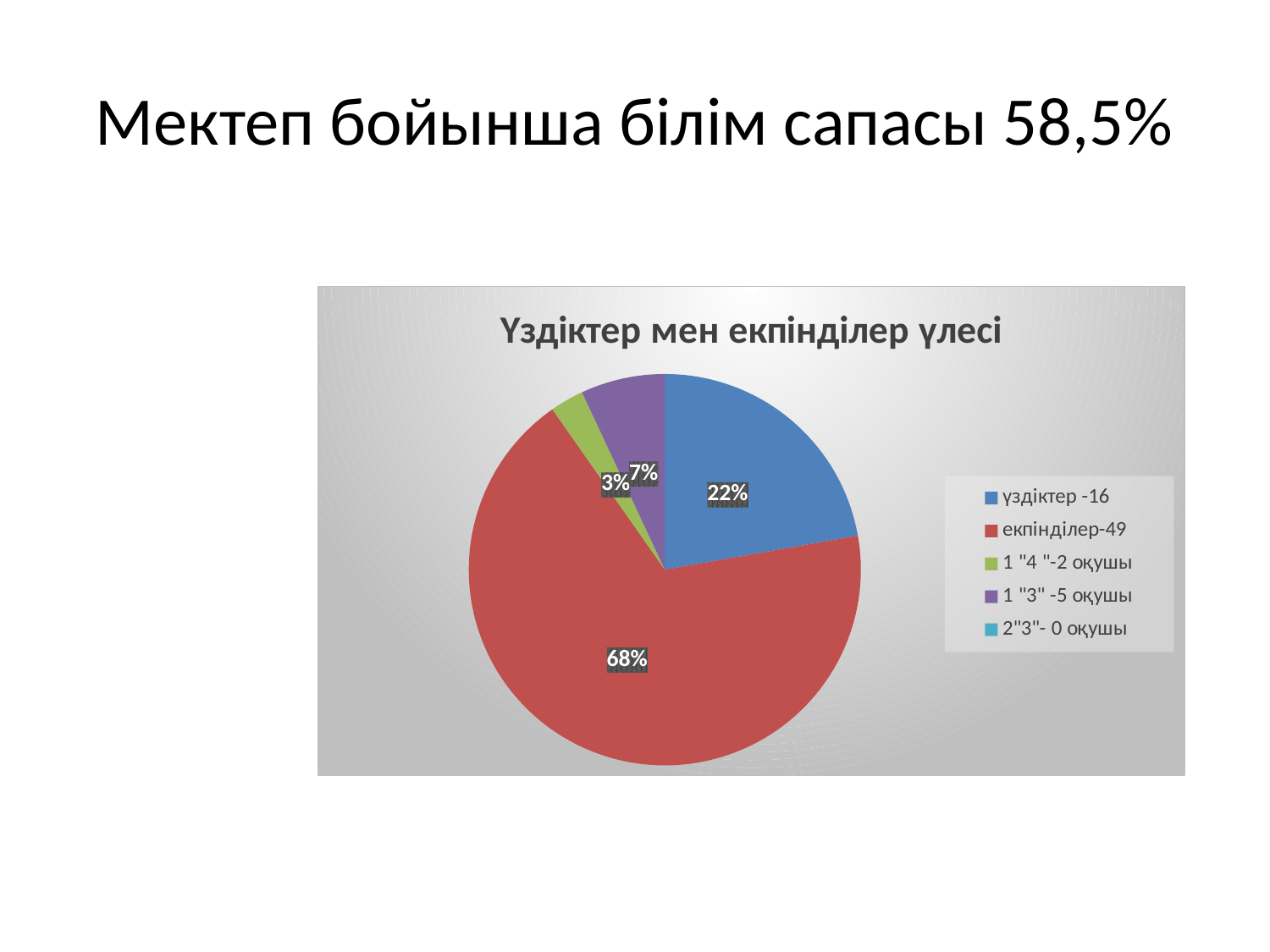
What is the difference in percentage points between the "екпінділер-49" slice and the "үздіктер -16" slice? 46 What share of the pie does the slice for "екпінділер-49" take? 68% What kind of chart is shown on the slide? pie chart Which category has the largest slice of the pie? екпінділер-49 Which slice is larger: "үздіктер -16" or "1 "3" -5 оқушы"? үздіктер -16 What is the title of the chart? Үздіктер мен екпінділер үлесі Which of the visible slices is the smallest? 1 "4" -2 оқушы What colour is the slice for "екпінділер-49"? red What share of the pie does the slice for "үздіктер -16" take? 22% How many entries does the chart legend list? 5 What share of the pie does the slice for "1 "3" -5 оқушы" take? 7%